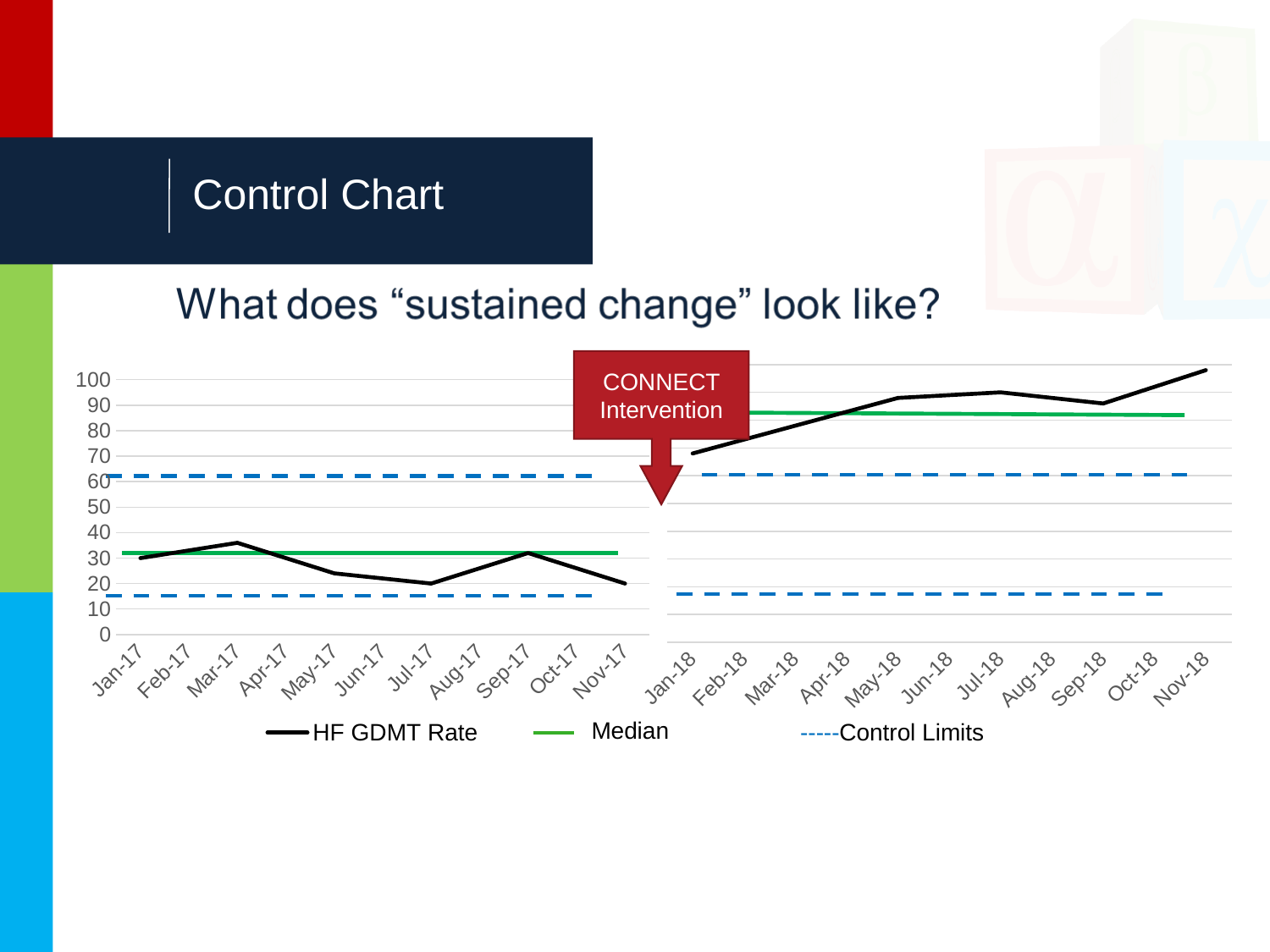
Is the HF GDMT Rate for Jan-18 greater or less than 60? greater How many months are labelled on the x axis? 22 Which month has the highest HF GDMT Rate? Nov-18 What colour is the Median line in the legend? green Does the HF GDMT Rate rise or fall from Jan-18 to May-18? rise What kind of chart is shown on the slide? line chart Is the HF GDMT Rate for Jul-17 greater or less than 30? less Which is larger, the HF GDMT Rate for Mar-17 or for Jul-17? Mar-17 Is the HF GDMT Rate for Nov-18 greater or less than 90? greater What intervention is labelled in the annotation box on the chart? CONNECT Intervention How many series does the legend list? 3